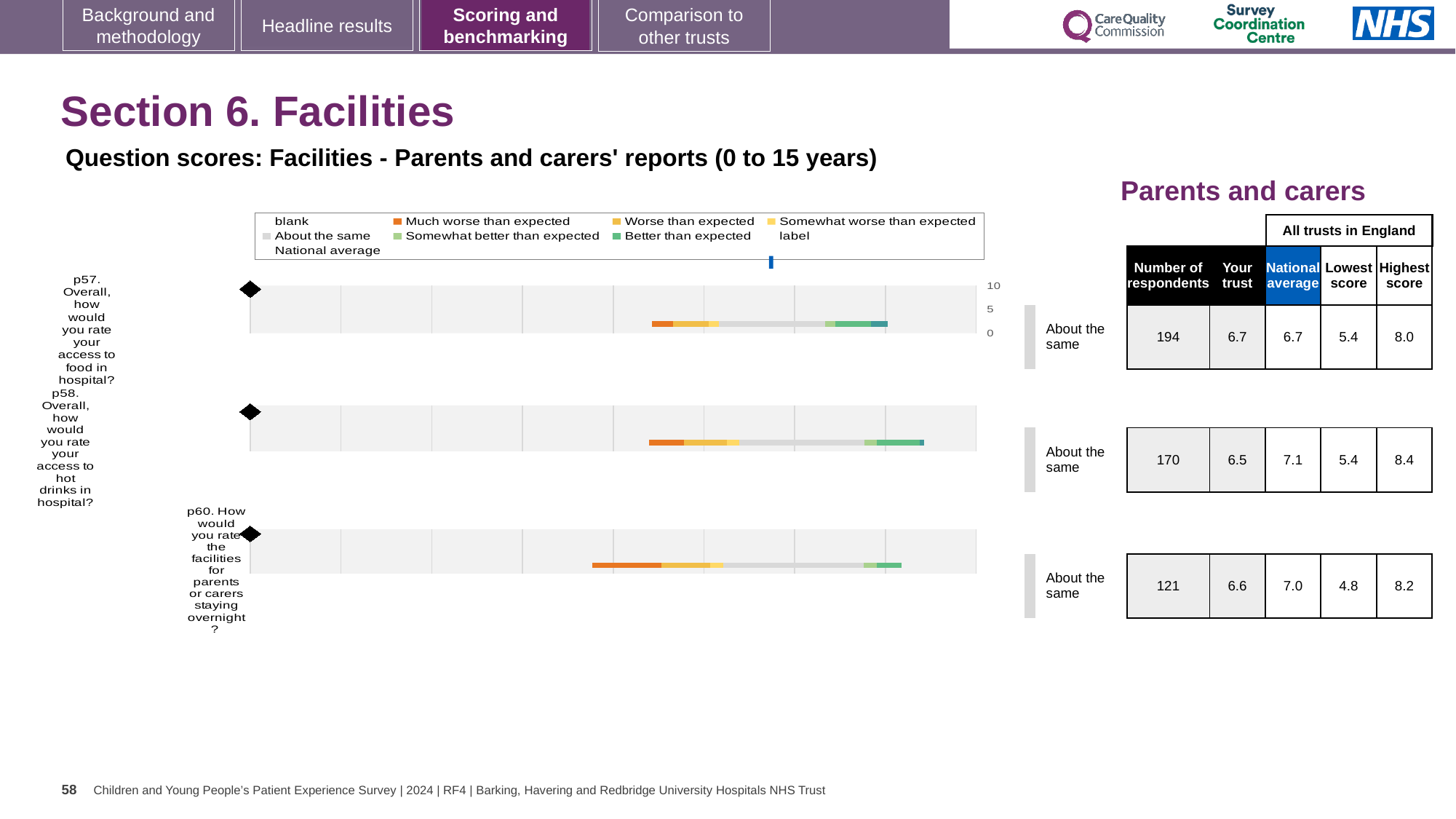
What is the number of respondents for p60 (facilities for parents or carers staying overnight)? 121 What colour represents 'Much worse than expected' in the legend? Orange What is the national average score for p58 (access to hot drinks in hospital)? 7.1 What is the maximum value shown on the score axis of the charts? 10 What kind of chart is used to show the question scores for p57, p58 and p60? bar chart What is the lowest score across all trusts in England for p60? 4.8 What is the difference between the national average and the 'Your trust' score for p58? 0.6 What is the highest score across all trusts in England for p58? 8.4 How many questions (categories) are plotted in the Facilities charts? 3 What is the 'Your trust' score for p57 (access to food in hospital)? 6.7 For p60, which is larger: the 'Your trust' score or the national average? National average Which question has the highest 'Your trust' score? p57